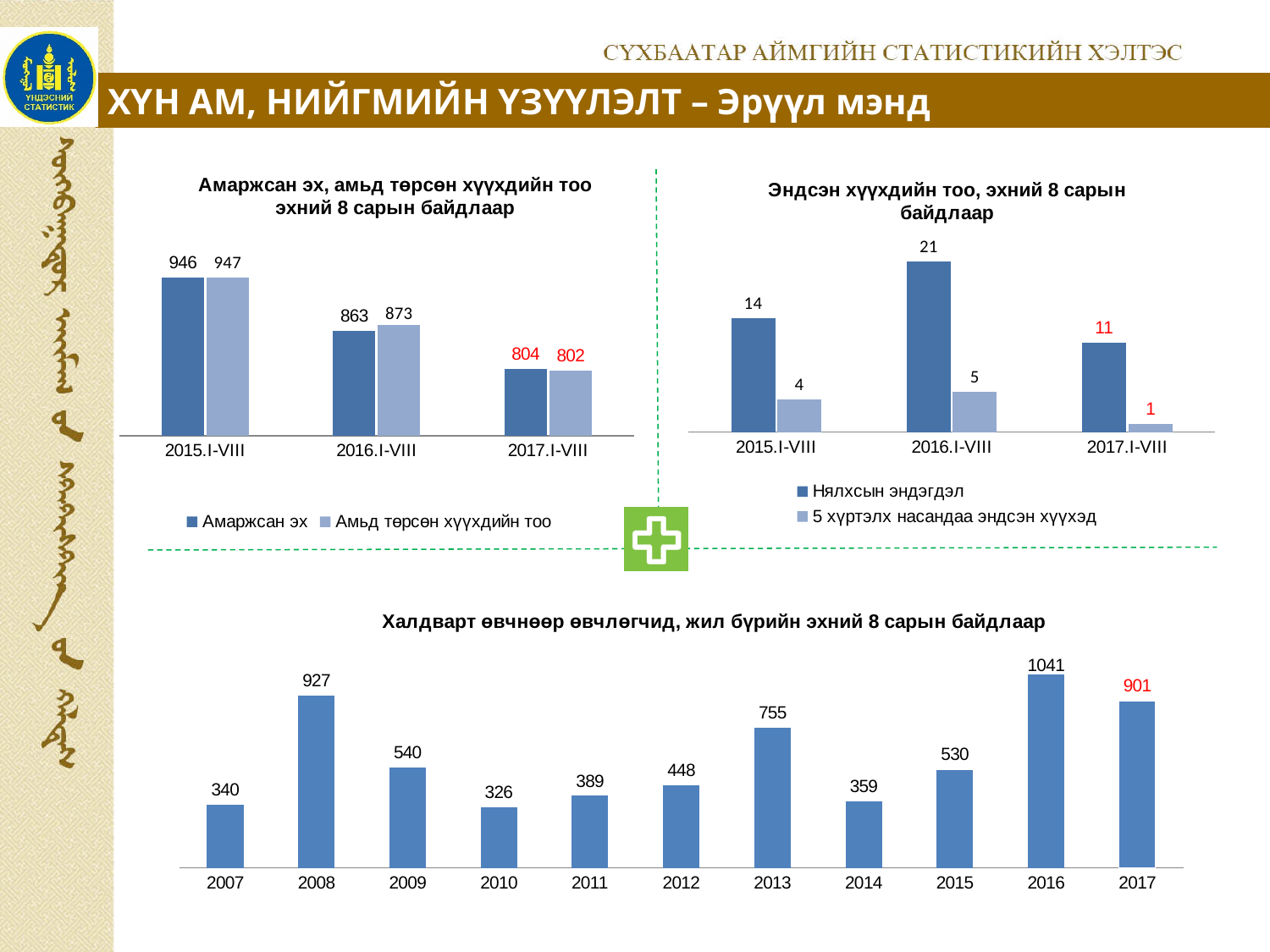
In the chart 'Амаржсан эх, амьд төрсөн хүүхдийн тоо эхний 8 сарын байдлаар', how many series does the legend list? 2 What kind of chart is 'Халдварт өвчнөөр өвчлөгчид, жил бүрийн эхний 8 сарын байдлаар'? Bar chart In the chart 'Эндсэн хүүхдийн тоо, эхний 8 сарын байдлаар', what is the difference between Нялхсын эндэгдэл and 5 хүртэлх насандаа эндсэн хүүхэд in 2015.I-VIII? 10 In the chart 'Халдварт өвчнөөр өвчлөгчид, жил бүрийн эхний 8 сарын байдлаар', which year has the highest value? 2016 In the chart 'Эндсэн хүүхдийн тоо, эхний 8 сарын байдлаар', which period has the lowest value for 5 хүртэлх насандаа эндсэн хүүхэд? 2017.I-VIII In the chart 'Халдварт өвчнөөр өвчлөгчид, жил бүрийн эхний 8 сарын байдлаар', what is the value for 2013? 755 In the chart 'Халдварт өвчнөөр өвчлөгчид, жил бүрийн эхний 8 сарын байдлаар', which year has the lowest value? 2010 In the chart 'Амаржсан эх, амьд төрсөн хүүхдийн тоо эхний 8 сарын байдлаар', what is the difference between the Амаржсан эх values for 2015.I-VIII and 2017.I-VIII? 142 In the chart 'Халдварт өвчнөөр өвчлөгчид, жил бүрийн эхний 8 сарын байдлаар', how many years are shown on the x axis? 11 In the chart 'Амаржсан эх, амьд төрсөн хүүхдийн тоо эхний 8 сарын байдлаар', what is the value for Амаржсан эх in 2016.I-VIII? 863 In the chart 'Амаржсан эх, амьд төрсөн хүүхдийн тоо эхний 8 сарын байдлаар', what is the value for Амьд төрсөн хүүхдийн тоо in 2017.I-VIII? 802 In the chart 'Эндсэн хүүхдийн тоо, эхний 8 сарын байдлаар', what is the value for Нялхсын эндэгдэл in 2016.I-VIII? 21